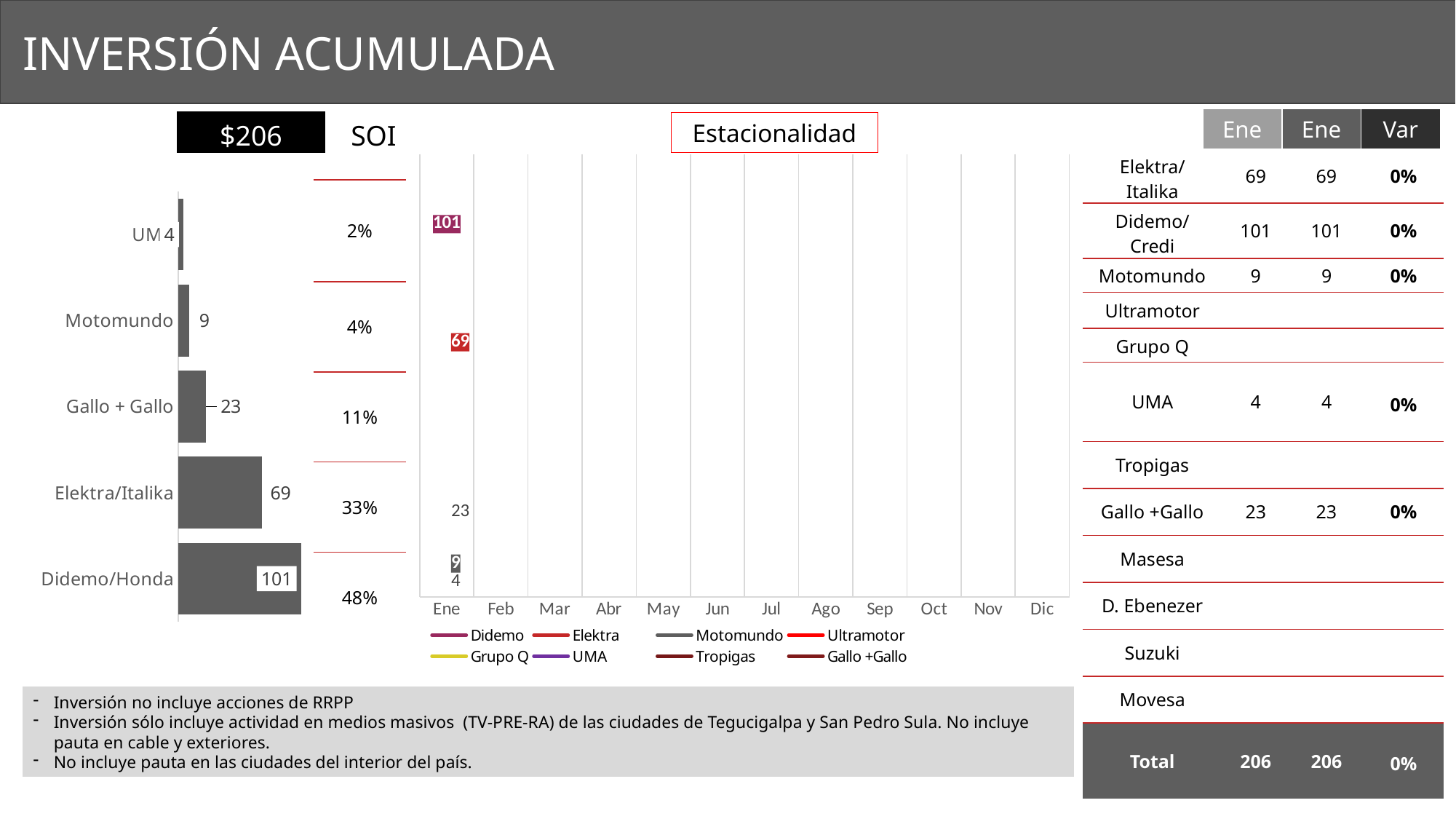
In the left bar chart, what is the value for Gallo + Gallo? 23 In the Estacionalidad chart, what is the value for Elektra in Ene? 69 In the left bar chart, which category has the lowest value? UMA In the left bar chart, which is larger, the value for Motomundo or the value for Gallo + Gallo? Gallo + Gallo What kind of chart is the chart on the left of the slide? bar chart How many series does the legend of the Estacionalidad chart list? 8 In the left bar chart, which category has the highest value? Didemo/Honda In the left bar chart, what is the value for Elektra/Italika? 69 How many months are shown on the x axis of the Estacionalidad chart? 12 In the Estacionalidad chart, what is the value for Didemo in Ene? 101 How many categories are shown in the left bar chart? 5 In the left bar chart, what is the difference between the values for Didemo/Honda and Elektra/Italika? 32